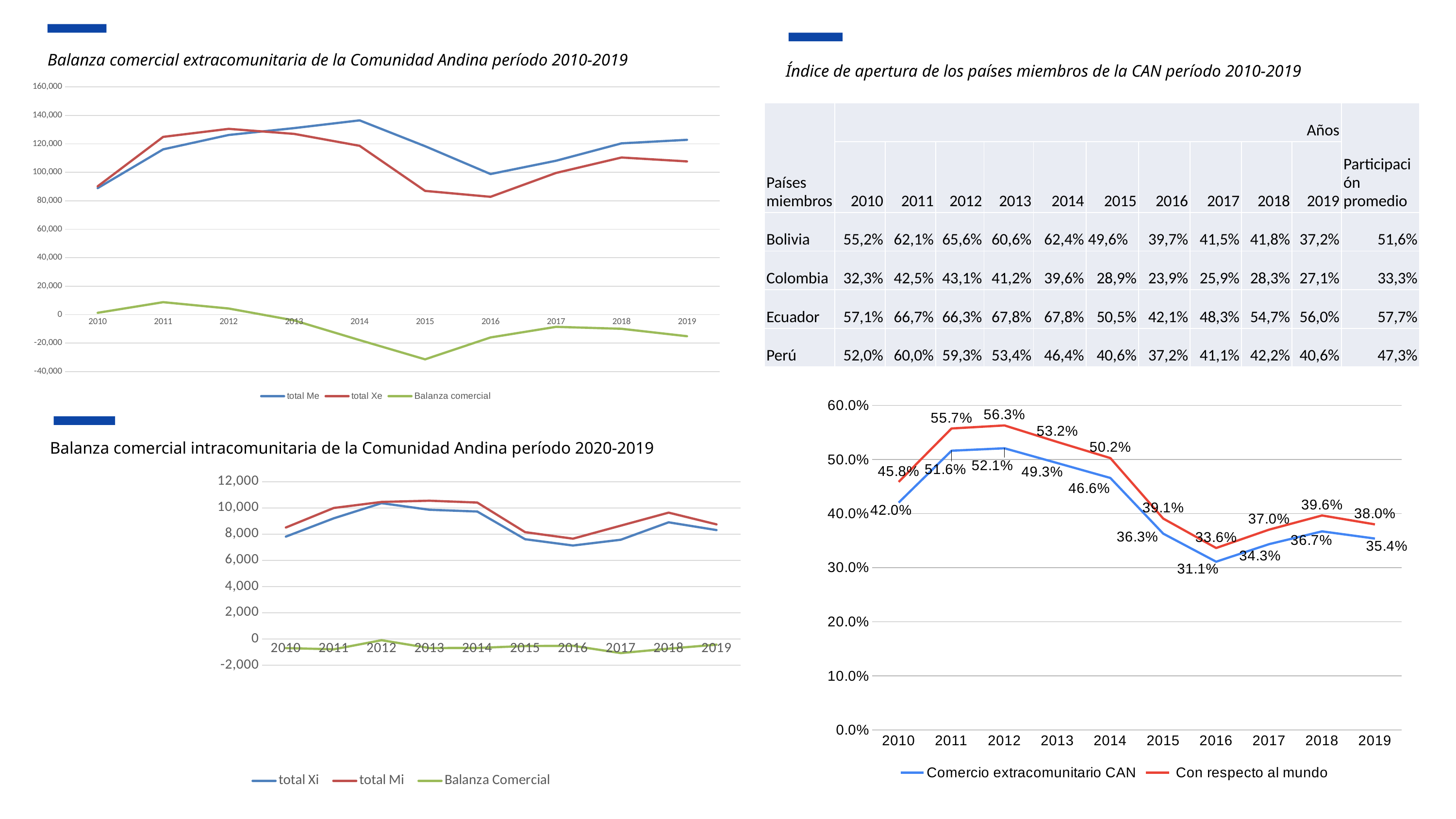
In the line chart on the right side of the slide (below the table), what is the value for 'Con respecto al mundo' in 2012? 56.3% In the top-left chart 'Balanza comercial extracomunitaria', how many years are plotted on the x axis? 10 In the top-left chart 'Balanza comercial extracomunitaria', is the value for Balanza comercial in 2015 greater or less than -20,000? less In the bottom-left chart 'Balanza comercial intracomunitaria', what are the three legend entries? total Xi, total Mi, Balanza Comercial In the bottom-left chart 'Balanza comercial intracomunitaria', is the value for total Xi in 2016 greater or less than 8,000? less In the line chart on the right side of the slide (below the table), in which year is 'Con respecto al mundo' lowest? 2016 What kind of chart is the top-left chart titled 'Balanza comercial extracomunitaria de la Comunidad Andina período 2010-2019'? Line chart In the top-left chart 'Balanza comercial extracomunitaria', is the value for total Me in 2014 greater or less than 120,000? greater In the line chart on the right side of the slide (below the table), do the values of 'Comercio extracomunitario CAN' rise or fall from 2014 to 2016? Fall In the top-left chart 'Balanza comercial extracomunitaria', how many series does the legend list? 3 In the line chart on the right side of the slide (below the table), in which year is 'Comercio extracomunitario CAN' highest? 2012 In the line chart on the right side of the slide (below the table), what is the difference between 'Con respecto al mundo' and 'Comercio extracomunitario CAN' in 2012? 4.2 percentage points